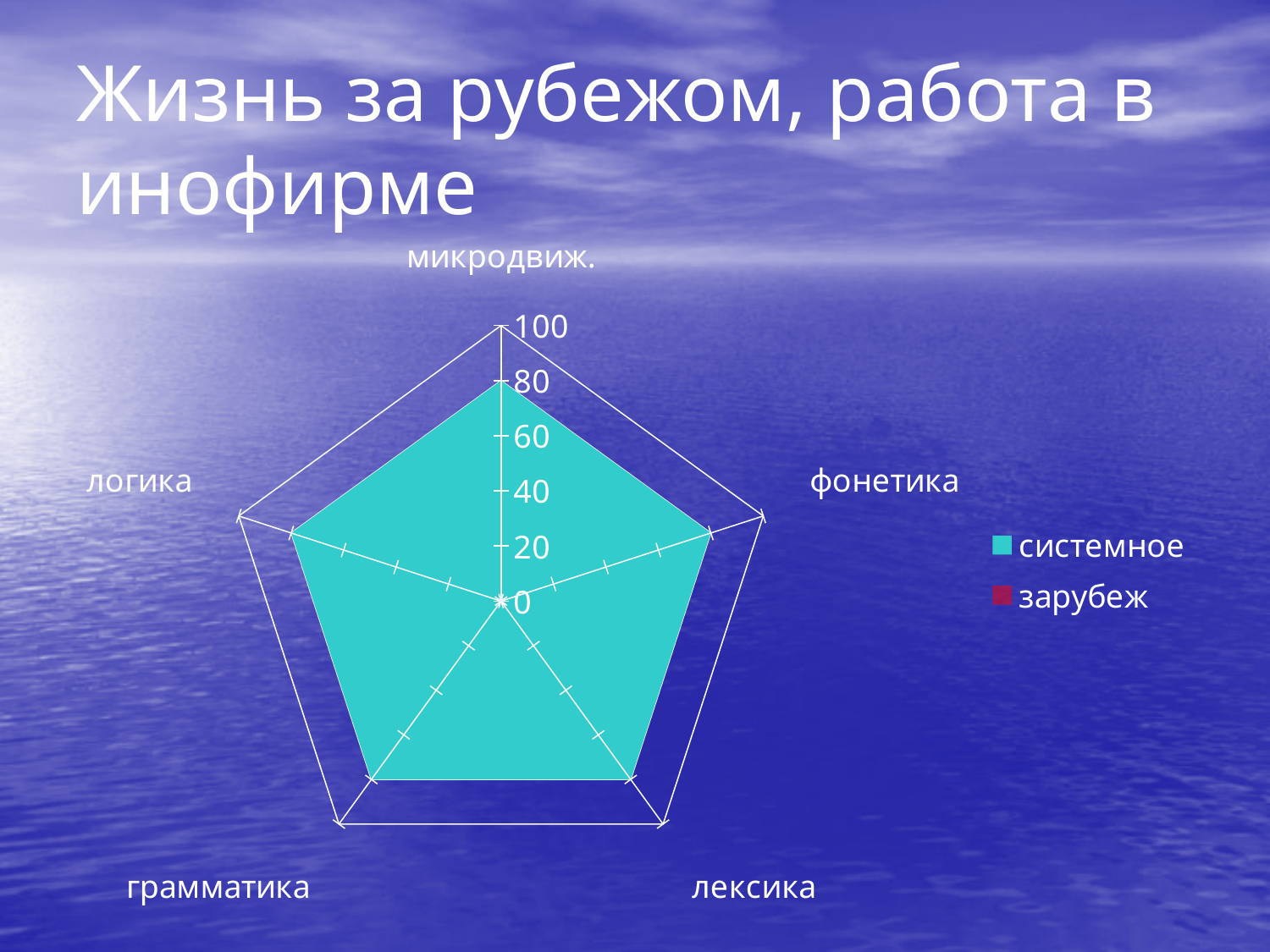
Is the value for лексика in the системное series greater or less than 100? less Which series names are listed in the chart legend? системное, зарубеж What is the value for микродвиж. in the системное series? 80 Is the value for грамматика in the системное series greater or less than 40? greater What is the maximum value shown on the chart's axis scale? 100 How many series does the legend of the chart list? 2 What kind of chart is shown on the slide? radar chart How many categories (axes) does the radar chart have? 5 Is the value for логика in the системное series greater or less than 100? less